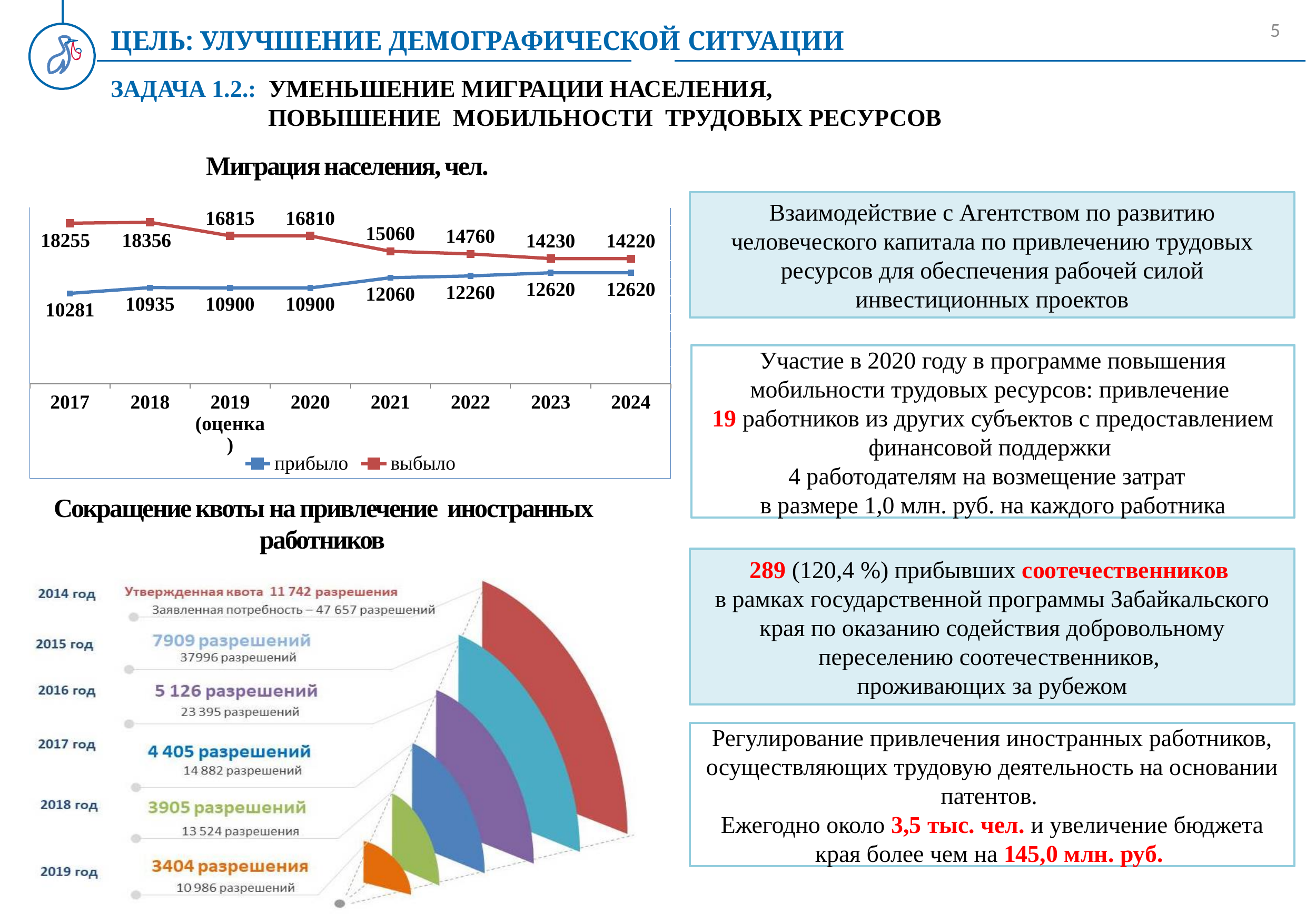
In the 'Миграция населения, чел.' chart, what is the value for 'прибыло' in 2021? 12060 In the 'Миграция населения, чел.' chart, in which year is the 'выбыло' series highest? 2018 In the 'Миграция населения, чел.' chart, how many years are shown on the x axis? 8 In the 'Сокращение квоты на привлечение иностранных работников' chart, what is the declared need (заявленная потребность) for 2019? 10 986 разрешений In the 'Миграция населения, чел.' chart, what is the difference between 'выбыло' and 'прибыло' in 2024? 1600 In the 'Миграция населения, чел.' chart, in which year is the 'прибыло' series lowest? 2017 In the 'Миграция населения, чел.' chart, how many series does the legend list? 2 In the 'Миграция населения, чел.' chart, does the 'выбыло' series generally rise or fall from 2017 to 2024? fall What type of chart is 'Миграция населения, чел.'? line chart In the 'Миграция населения, чел.' chart, which series has the larger value in 2020, 'прибыло' or 'выбыло'? выбыло In the 'Сокращение квоты на привлечение иностранных работников' chart, how many permits were in the approved quota for 2014? 11 742 In the 'Миграция населения, чел.' chart, what is the value for 'выбыло' in 2017? 18255